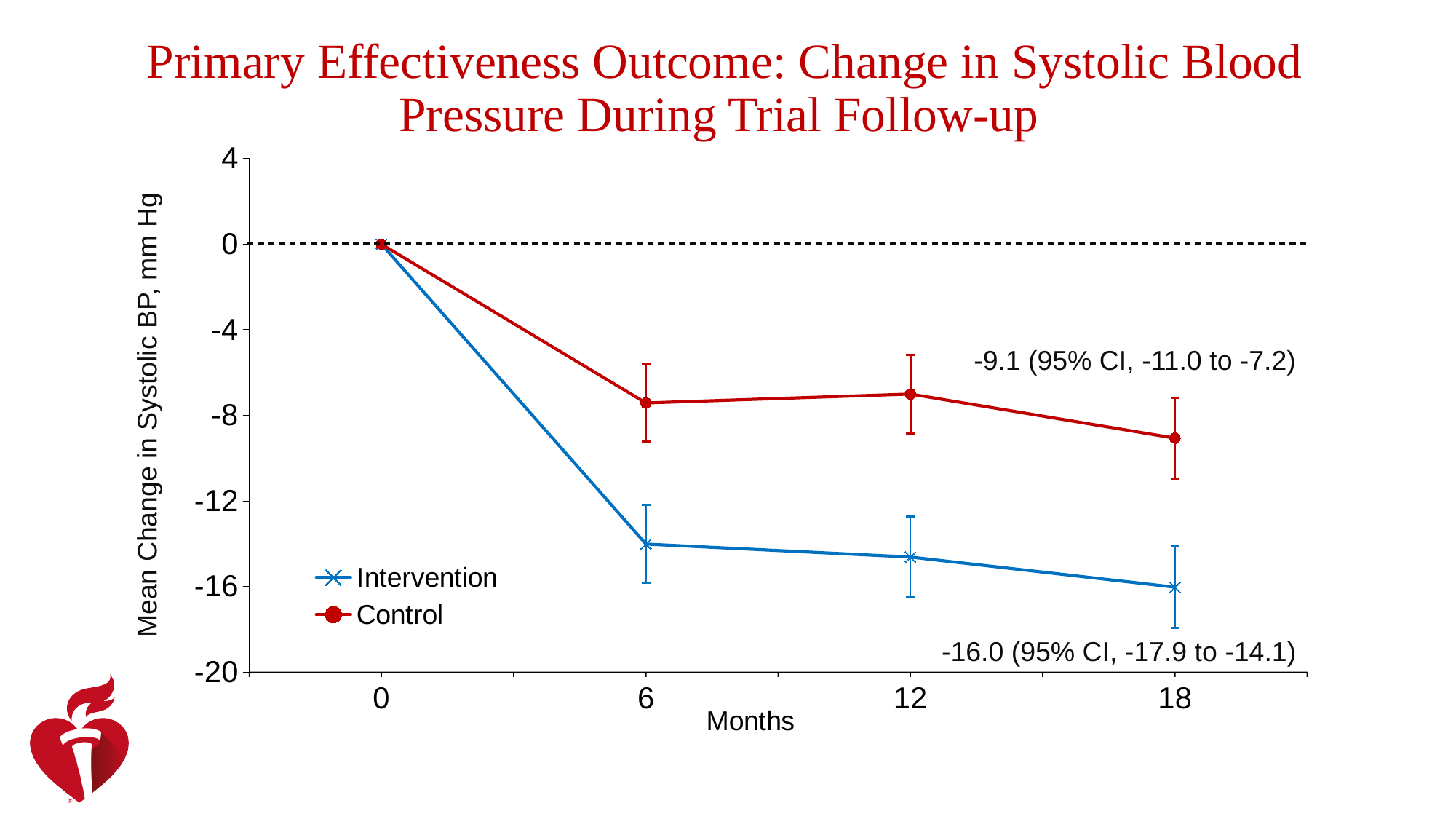
At 18 months, which group has the lower mean change in systolic BP? Intervention What is the 95% confidence interval for the Control group at 18 months? -11.0 to -7.2 What is the 95% confidence interval for the Intervention group at 18 months? -17.9 to -14.1 What is the mean change in systolic BP for the Control group at 18 months? -9.1 How many series does the legend list? 2 What kind of chart is shown on the slide? Line chart Do the Intervention group's values rise or fall from 0 to 18 months? Fall How many time points are plotted on the x axis? 4 Is the value for the Control group at 6 months greater or less than -4? less What is the mean change in systolic BP for the Intervention group at 18 months? -16.0 What is the difference between the Control and Intervention mean changes at 18 months? 6.9 Is the value for the Intervention group at 6 months greater or less than -12? less